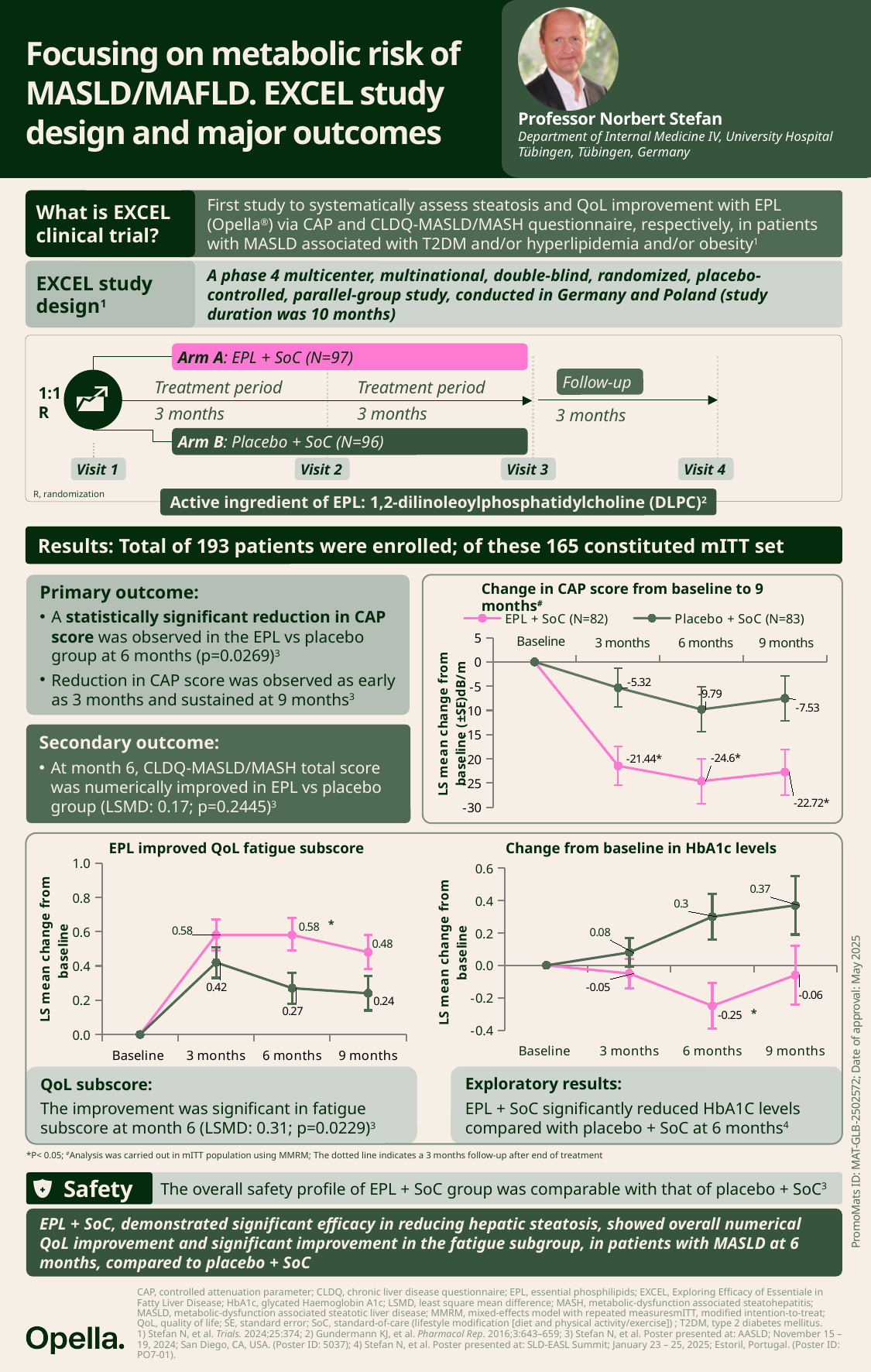
In the 'Change in CAP score from baseline to 9 months' chart, at which time point is the EPL + SoC value lowest? 6 months In the 'Change in CAP score from baseline to 9 months' chart, what is the value for Placebo + SoC at 3 months? -5.32 How many series does the legend of the 'Change in CAP score from baseline to 9 months' chart list? 2 In the 'EPL improved QoL fatigue subscore' chart, what is the difference between the pink and green lines at 3 months? 0.16 In the 'EPL improved QoL fatigue subscore' chart, what is the value of the pink (EPL + SoC) line at 9 months? 0.48 In the 'Change from baseline in HbA1c levels' chart, what is the value of the green (Placebo + SoC) line at 9 months? 0.37 In the 'Change from baseline in HbA1c levels' chart, which line has the larger value at 6 months, the pink (EPL + SoC) or the green (Placebo + SoC)? Green (Placebo + SoC) In the 'Change in CAP score from baseline to 9 months' chart, what is the difference between the Placebo + SoC and EPL + SoC values at 9 months? 15.19 What kind of chart is the 'Change in CAP score from baseline to 9 months' chart? Line chart In the 'EPL improved QoL fatigue subscore' chart, what is the value of the green (Placebo + SoC) line at 6 months? 0.27 In the 'Change in CAP score from baseline to 9 months' chart, what is the value for EPL + SoC at 6 months? -24.6 How many time points are plotted on the x axis of the 'EPL improved QoL fatigue subscore' chart? 4